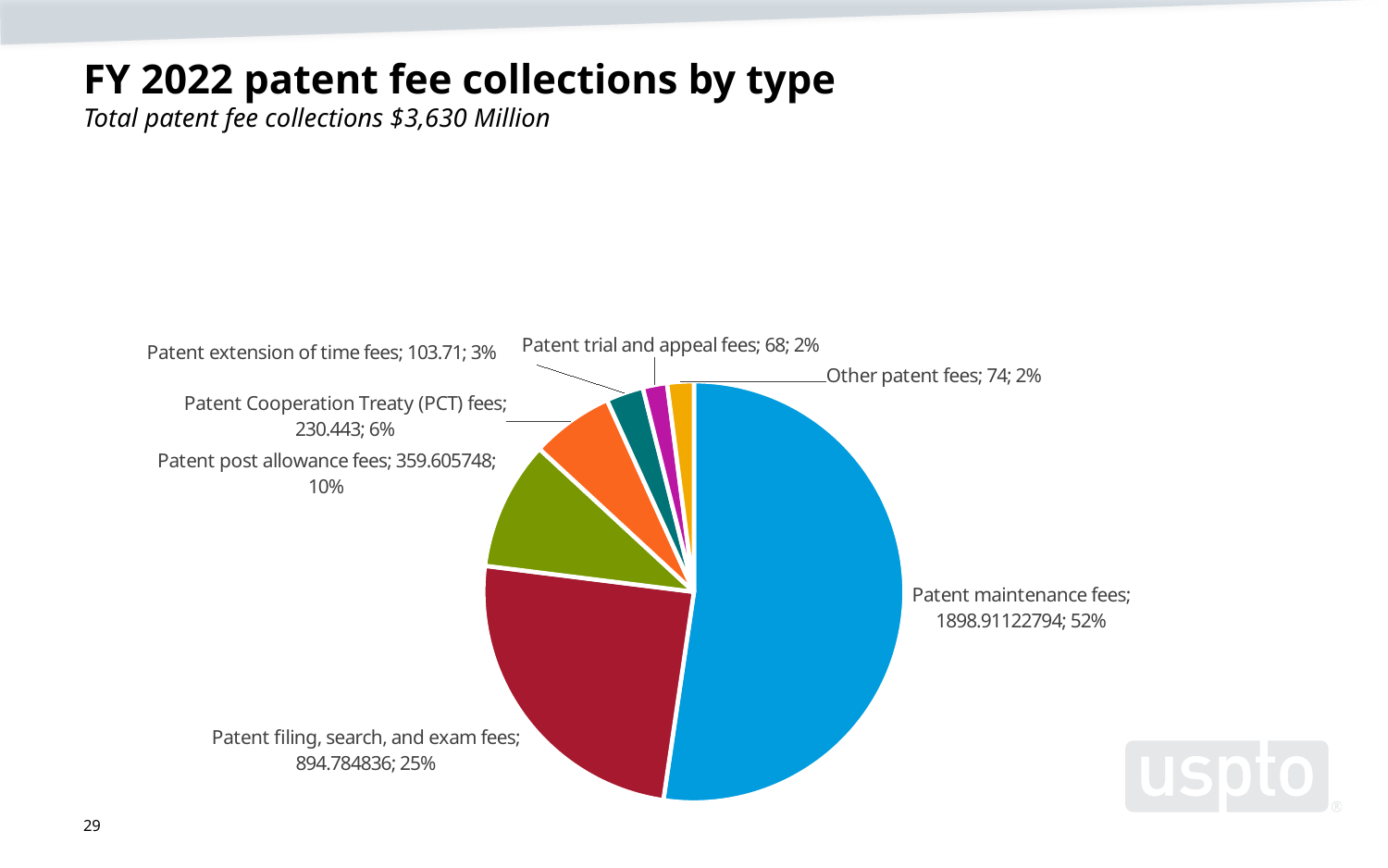
Which is larger, Other patent fees or Patent extension of time fees? Patent extension of time fees How many slices does the pie chart have? 7 What is the value for Patent maintenance fees? 1898.91122794 Which fee type has the smallest slice? Patent trial and appeal fees What is the value for Patent Cooperation Treaty (PCT) fees? 230.443 What share of the pie is Patent filing, search, and exam fees? 25% Which fee type has the largest slice? Patent maintenance fees What kind of chart is shown on the slide? Pie chart What is the value for Patent post allowance fees? 359.605748 What is the value for Patent trial and appeal fees? 68 What share of the pie is Patent extension of time fees? 3% What is the value for Patent filing, search, and exam fees? 894.784836